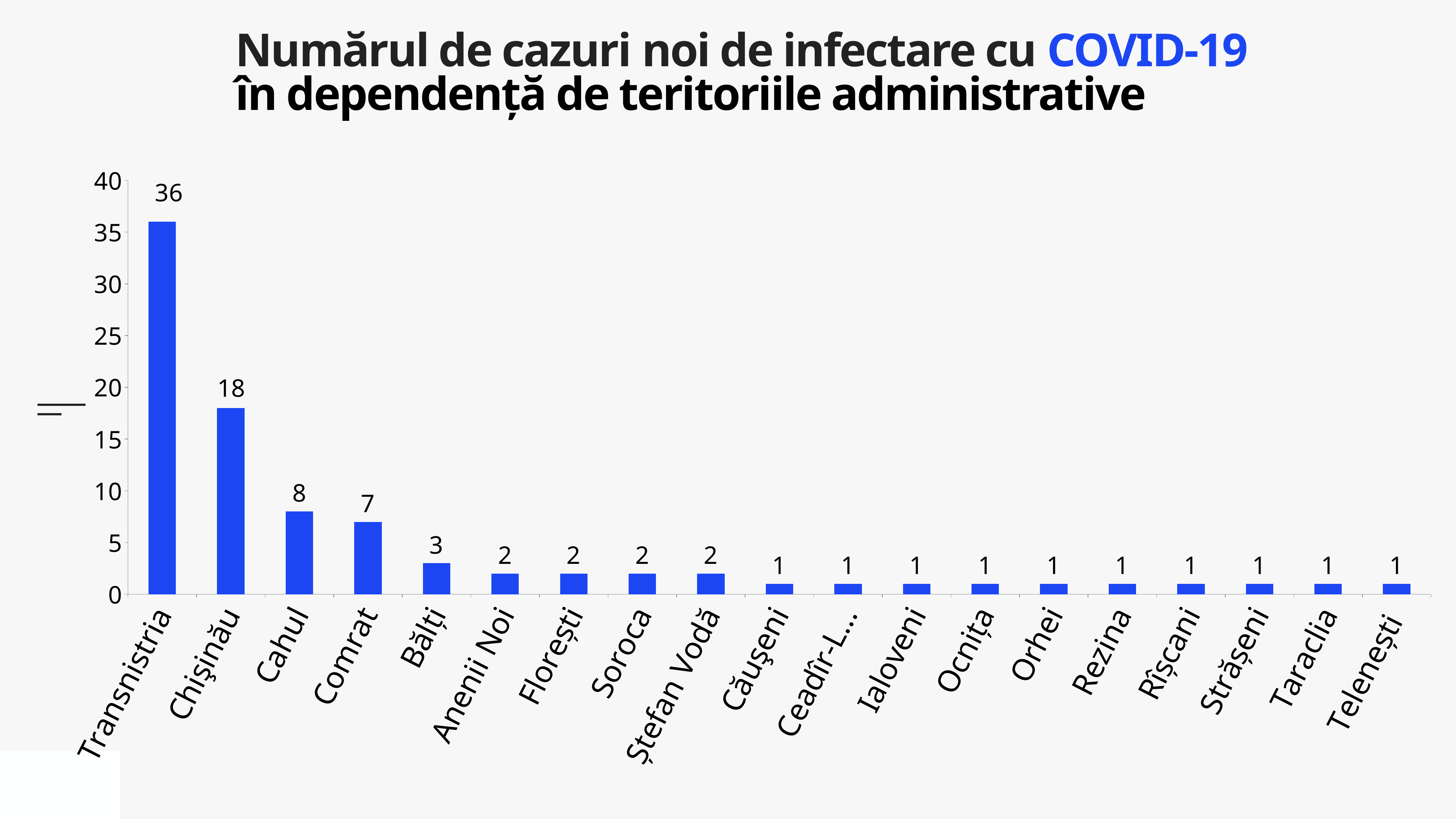
Do the values rise or fall from left to right along the x axis? Fall What is the value for Chișinău? 18 Which category has the highest value? Transnistria What is the value for Bălți? 3 How many categories are shown on the x axis? 19 What kind of chart is shown on the slide? Bar chart Which is larger, the value for Comrat or the value for Bălți? Comrat What is the value for Cahul? 8 What is the value for Transnistria? 36 What is the difference between the values for Cahul and Comrat? 1 What is the difference between the values for Transnistria and Chișinău? 18 What is the value for Soroca? 2